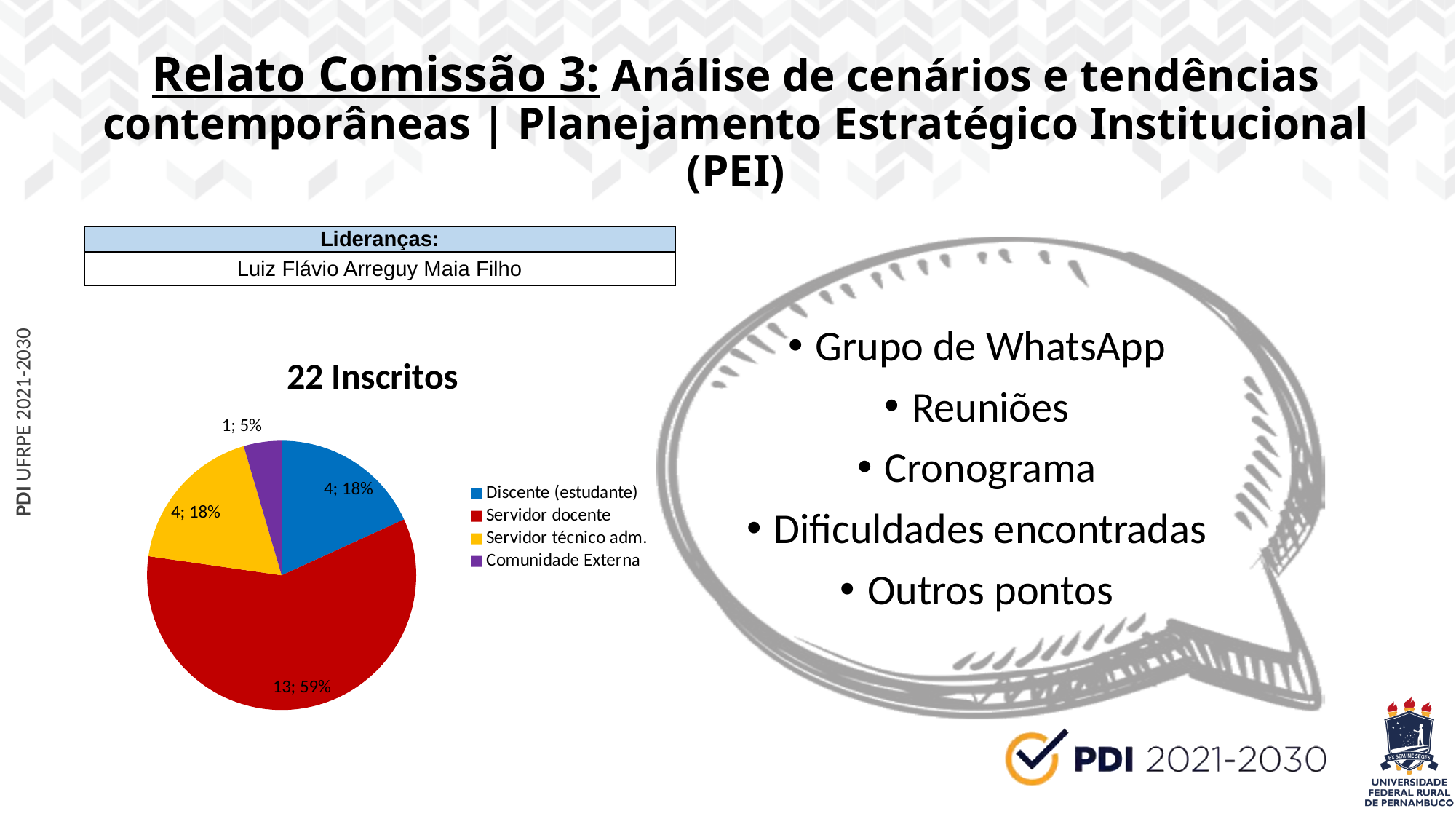
How many slices does the pie chart have? 4 What share of the pie does Servidor técnico adm. represent? 18% What is the title of the pie chart? 22 Inscritos Which category has the largest slice in the pie chart? Servidor docente What share of the pie does Servidor docente represent? 59% Which category has the smallest slice in the pie chart? Comunidade Externa What is the value for Discente (estudante) in the pie chart? 4 What is the value for Servidor docente in the pie chart? 13 What is the difference between the values for Servidor docente and Comunidade Externa? 12 What is the value for Comunidade Externa in the pie chart? 1 What kind of chart is shown on the slide? pie chart How many entries does the legend of the pie chart list? 4